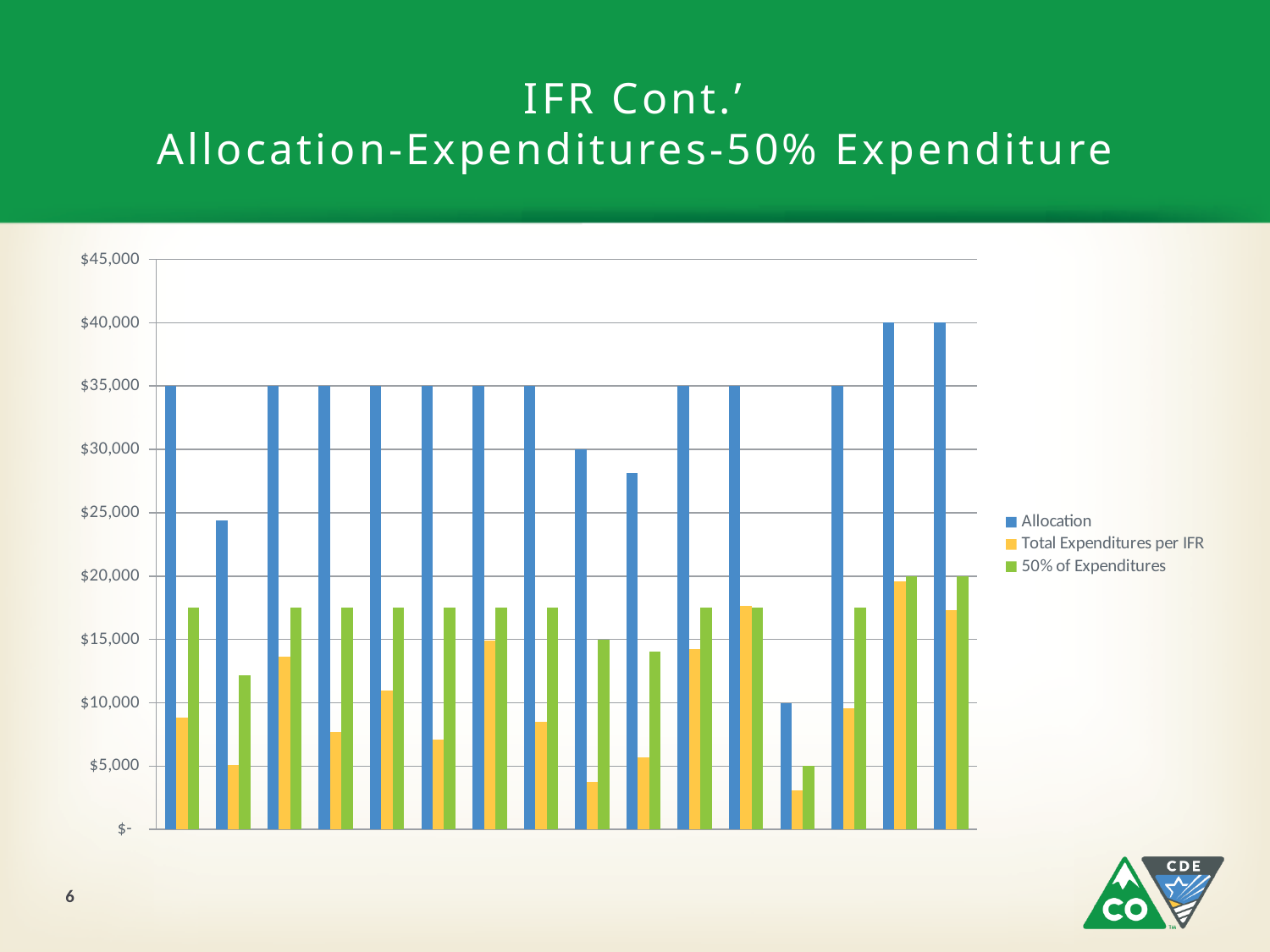
What is the lowest value of the 50% of Expenditures series? $5,000 What kind of chart is shown on the slide? bar chart Is the Total Expenditures per IFR value for the first group of bars greater or less than $10,000? less What is the highest value of the 50% of Expenditures series? $20,000 What are the three series named in the legend? Allocation, Total Expenditures per IFR, 50% of Expenditures Which colour represents the Allocation series? blue Is the Allocation value for the second group of bars greater or less than $25,000? less What is the lowest Allocation value shown on the chart? $10,000 What is the highest Allocation value shown on the chart? $40,000 How many groups of bars are plotted along the x axis? 16 In the last group of bars, which is larger: the Allocation value or the Total Expenditures per IFR value? Allocation How many series does the legend list? 3